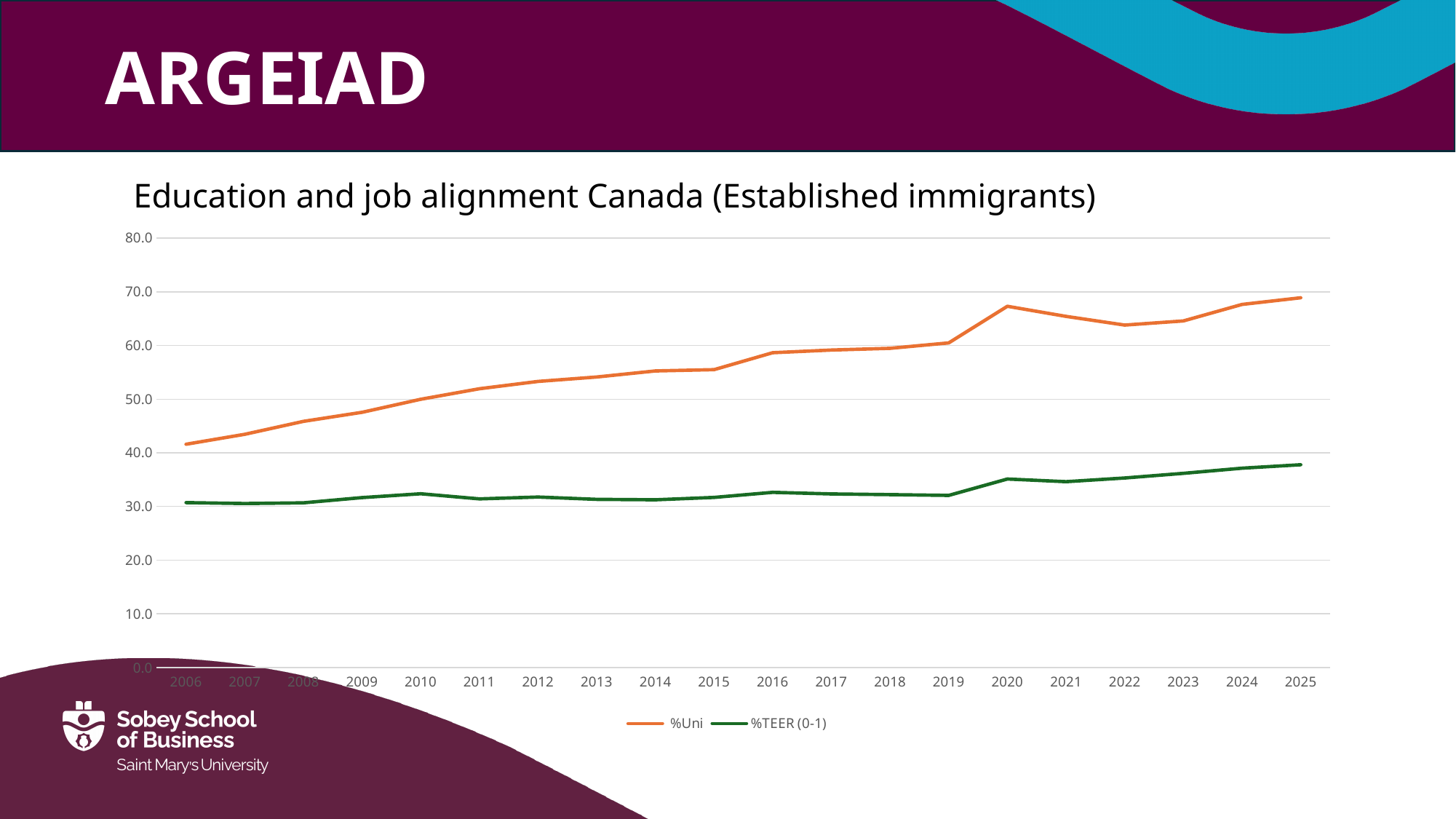
What is the title of the chart? Education and job alignment Canada (Established immigrants) Does the %Uni series generally rise or fall from 2006 to 2025? rise Is the %TEER (0-1) value for 2025 greater or less than 40? less How many years are plotted along the x axis? 20 Is the %TEER (0-1) value for 2006 greater or less than 40? less In which year is the %Uni series at its highest? 2025 How many series does the legend list? 2 In which year is the %Uni series at its lowest? 2006 Is the %Uni value for 2006 greater or less than 50? less What kind of chart is shown on the slide? line chart In 2025, which series has the larger value, %Uni or %TEER (0-1)? %Uni